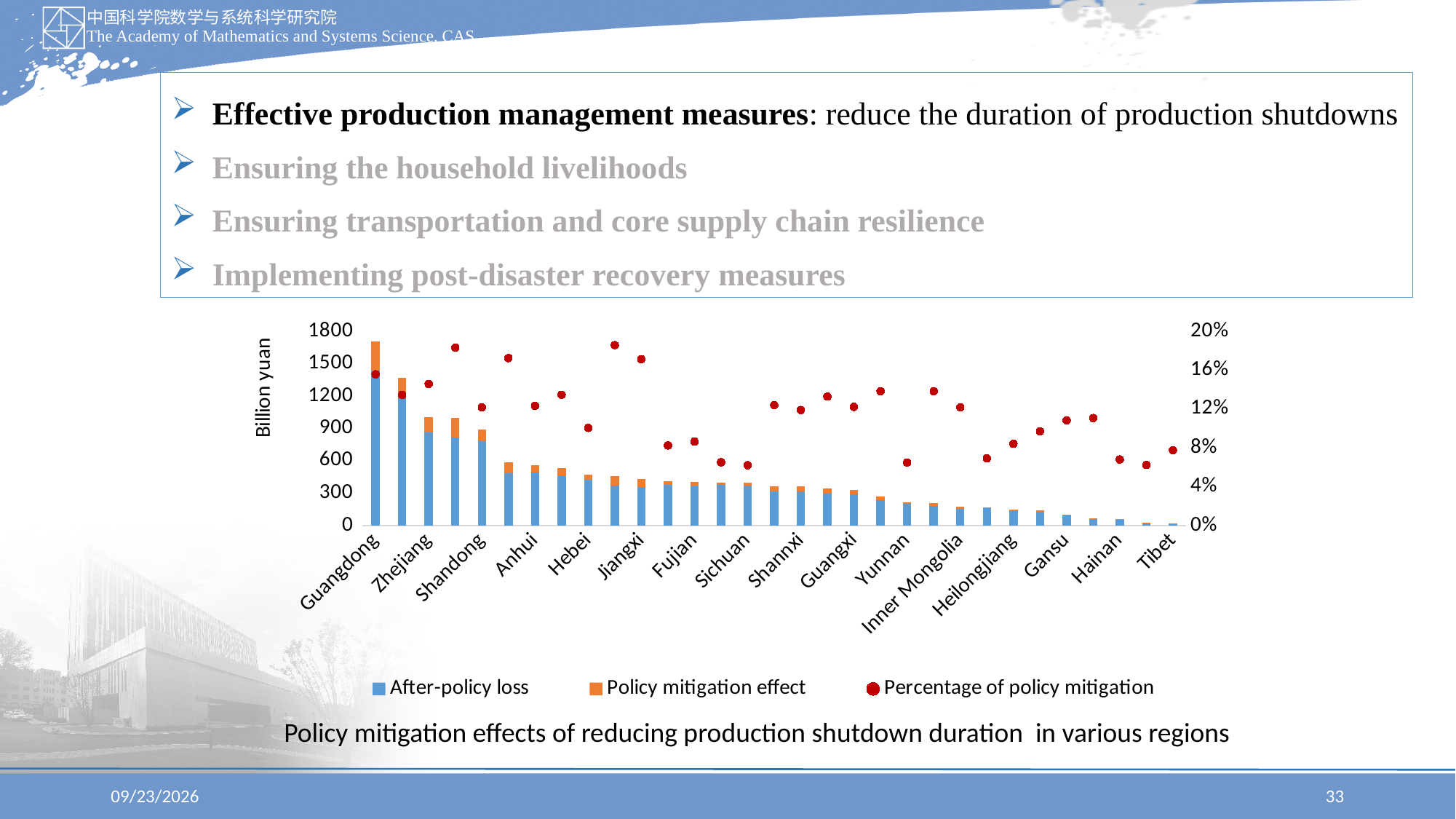
Which labelled region has the shortest bar in the chart? Tibet Is the total bar height for Tibet greater or less than 300 billion yuan? less Is the Percentage of policy mitigation for Hainan greater or less than 8%? less How many series does the chart legend list? 3 What kind of chart is used to show the After-policy loss and Policy mitigation effect series? bar chart Do the bar heights generally rise or fall moving from left to right along the x axis? fall What unit is shown on the left vertical axis of the chart? Billion yuan Which region has the higher Percentage of policy mitigation, Jiangxi or Sichuan? Jiangxi Which region has the tallest bar (largest total loss) in the chart? Guangdong Is the Percentage of policy mitigation for Guangdong greater or less than 12%? greater Which has the larger total bar, Guangdong or Zhejiang? Guangdong